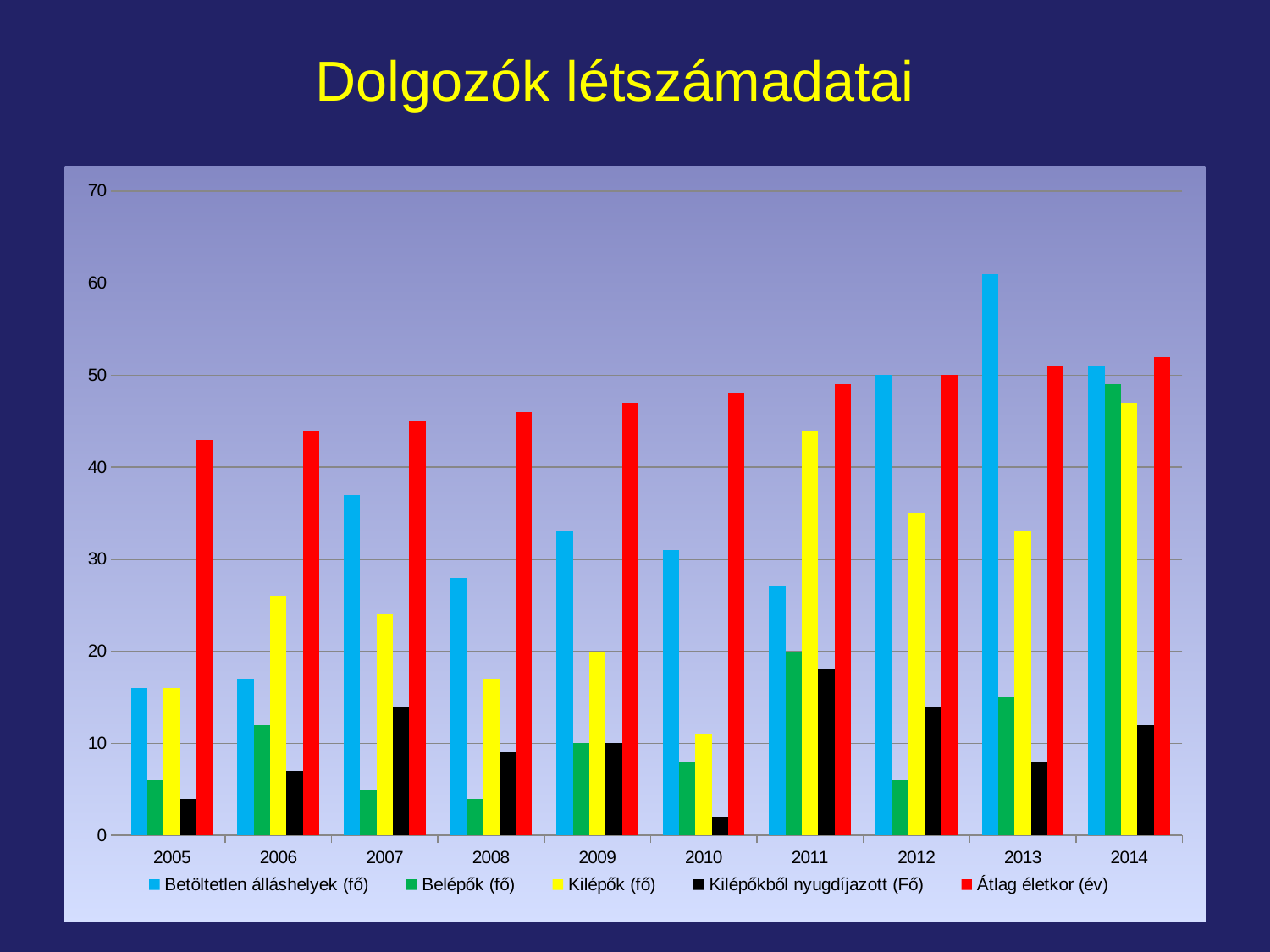
Is the value for Betöltetlen álláshelyek (fő) in 2013 greater or less than 50? greater How many years are shown on the x axis? 10 In which year is the value for Kilépőkből nyugdíjazott (Fő) the lowest? 2010 How many series does the legend list? 5 Which is larger in 2011: Kilépők (fő) or Betöltetlen álláshelyek (fő)? Kilépők (fő) What kind of chart is shown on the slide? bar chart What is the title of the chart? Dolgozók létszámadatai In which year is the value for Betöltetlen álláshelyek (fő) the highest? 2013 In which year is the value for Belépők (fő) the highest? 2014 Is the value for Kilépők (fő) in 2011 greater or less than 40? greater In which year is the value for Kilépőkből nyugdíjazott (Fő) the highest? 2011 Does the value for Átlag életkor (év) generally rise or fall from 2005 to 2014? rise